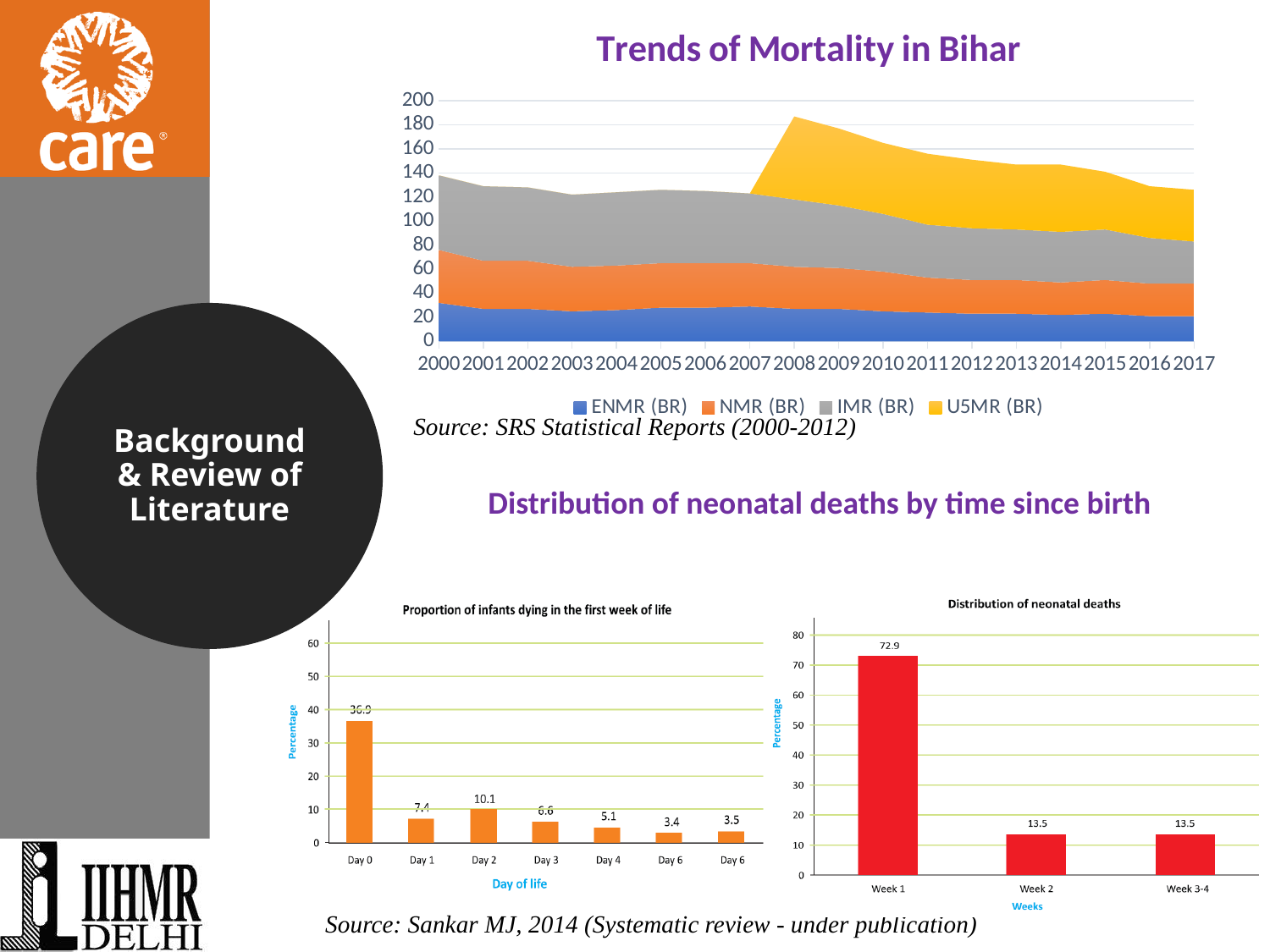
In the 'Trends of Mortality in Bihar' chart, which series is shown in yellow? U5MR (BR) In the 'Proportion of infants dying in the first week of life' chart, what is the value for Day 0? 36.9 In the 'Proportion of infants dying in the first week of life' chart, which is larger, the value for Day 1 or Day 2? Day 2 In the 'Distribution of neonatal deaths' chart, what is the difference between the values for Week 1 and Week 2? 59.4 How many bars are in the 'Proportion of infants dying in the first week of life' chart? 7 What kind of chart is the 'Trends of Mortality in Bihar' chart? Stacked area chart How many series does the legend of the 'Trends of Mortality in Bihar' chart list? 4 What kind of chart is the 'Distribution of neonatal deaths' chart? Bar chart In the 'Distribution of neonatal deaths' chart, what is the value for Week 1? 72.9 In the 'Proportion of infants dying in the first week of life' chart, what is the difference between the values for Day 0 and Day 1? 29.5 In the 'Proportion of infants dying in the first week of life' chart, which day has the highest value? Day 0 How many years are shown on the x axis of the 'Trends of Mortality in Bihar' chart? 18